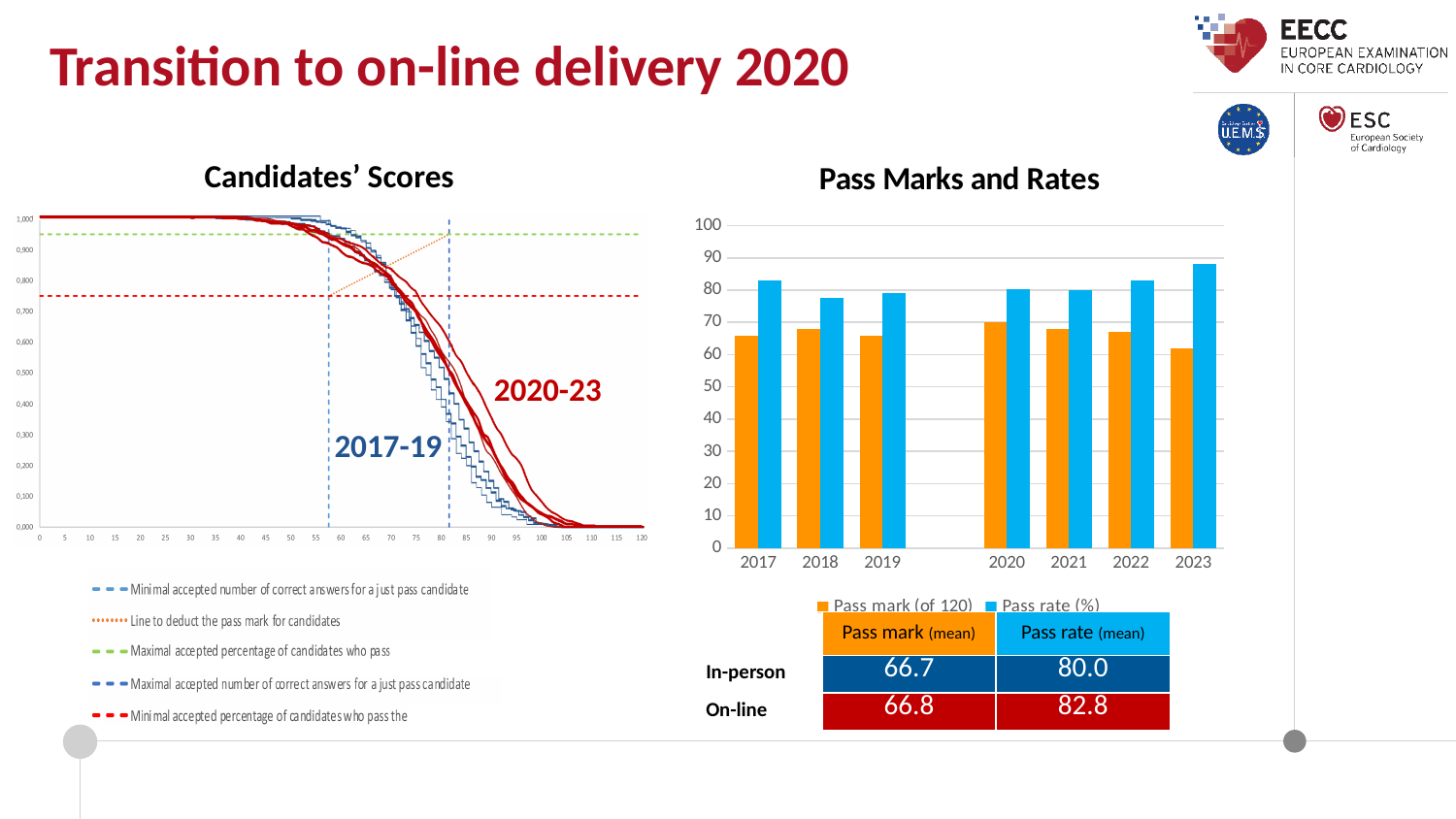
In the 'Pass Marks and Rates' chart, is the pass rate (%) for 2023 greater or less than 80? greater In the 'Pass Marks and Rates' chart, which year has the lowest pass mark (of 120)? 2023 What kind of chart is the 'Candidates' Scores' chart? line chart In the 'Pass Marks and Rates' chart, how many years are shown on the x axis? 7 In the 'Pass Marks and Rates' chart, which is larger: the pass rate (%) for 2023 or for 2018? 2023 In the 'Pass Marks and Rates' chart, how many series does the legend list? 2 In the 'Pass Marks and Rates' chart, is the pass mark (of 120) for 2023 greater or less than 70? less In the 'Pass Marks and Rates' chart, which year has the highest pass rate (%)? 2023 In the 'Pass Marks and Rates' chart, which year has the lowest pass rate (%)? 2018 What kind of chart is the 'Pass Marks and Rates' chart? bar chart In the 'Candidates' Scores' chart, which group of years is plotted in red? 2020-23 In the 'Pass Marks and Rates' chart, does the pass mark (of 120) rise or fall from 2020 to 2023? fall